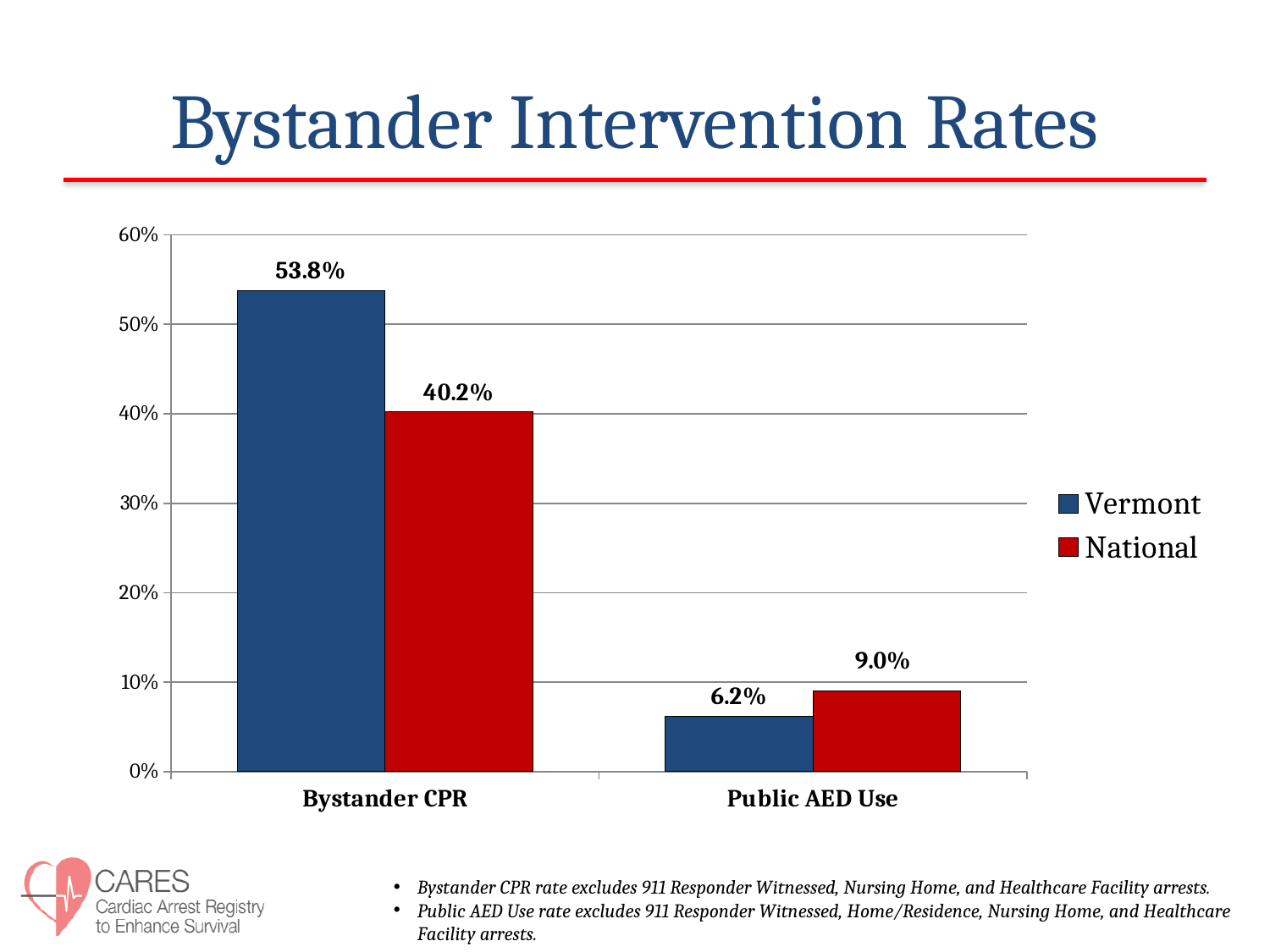
What is the title of the chart? Bystander Intervention Rates What kind of chart is shown on the slide? Bar chart How many series does the legend list? 2 What is the Vermont value for Bystander CPR? 53.8% How many categories are shown on the x axis? 2 What is the difference between the Vermont and National values for Bystander CPR? 13.6% What is the National value for Bystander CPR? 40.2% What is the National value for Public AED Use? 9.0% What is the Vermont value for Public AED Use? 6.2% Which category has the highest Vermont value? Bystander CPR Which is larger for Public AED Use, the Vermont value or the National value? National Which category has the lowest National value? Public AED Use